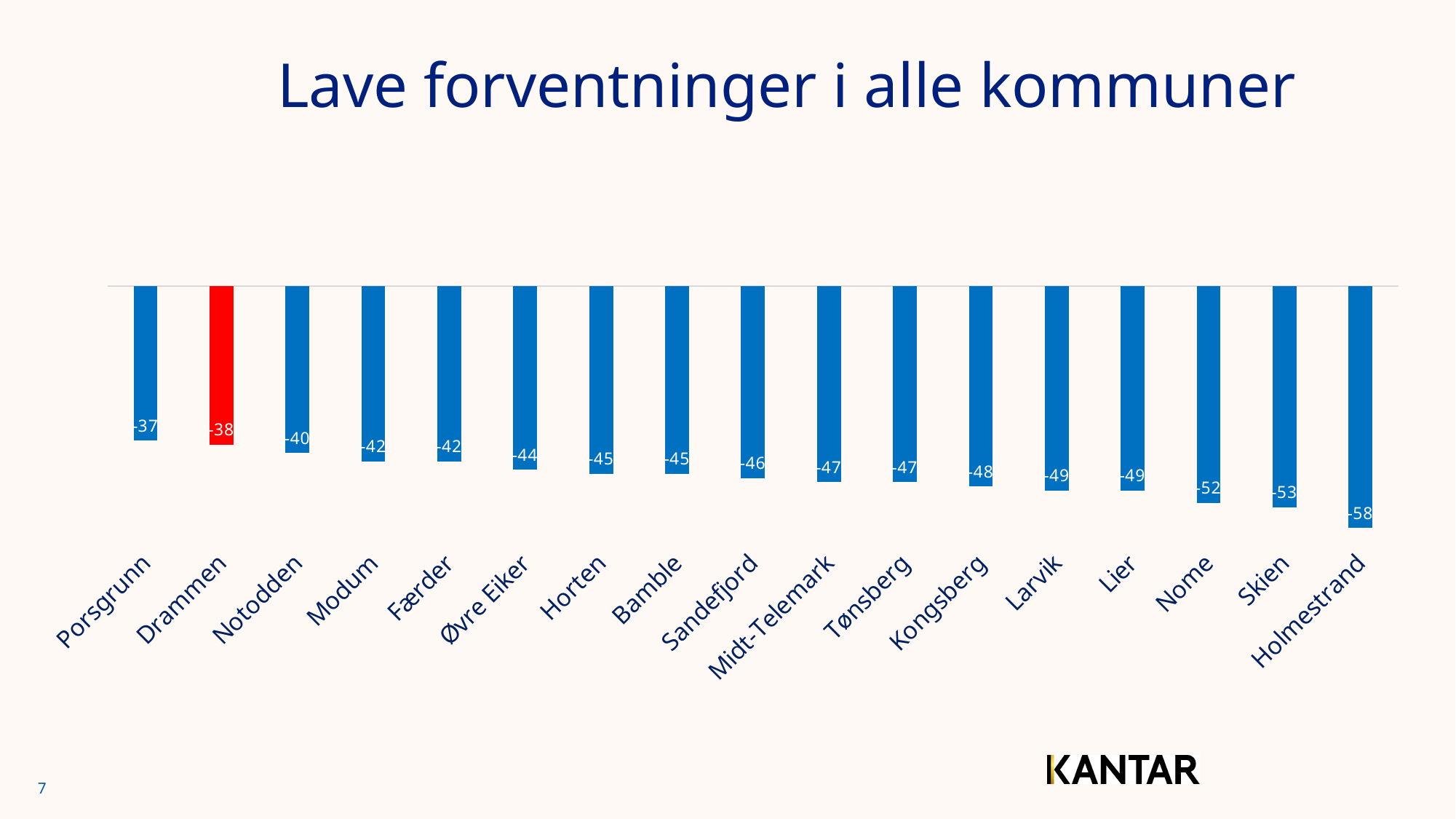
What is the value for Drammen? -38 Do the values rise or fall from left to right along the x axis? Fall Which municipality's bar is coloured red? Drammen What is the difference between the values for Porsgrunn and Holmestrand? 21 How many municipalities are shown in the chart? 17 What is the value for Sandefjord? -46 What kind of chart is shown on the slide? Bar chart What is the value for Nome? -52 Which has the larger value, Skien or Notodden? Notodden Which municipality has the highest value? Porsgrunn Which municipality has the lowest value? Holmestrand What is the value for Holmestrand? -58